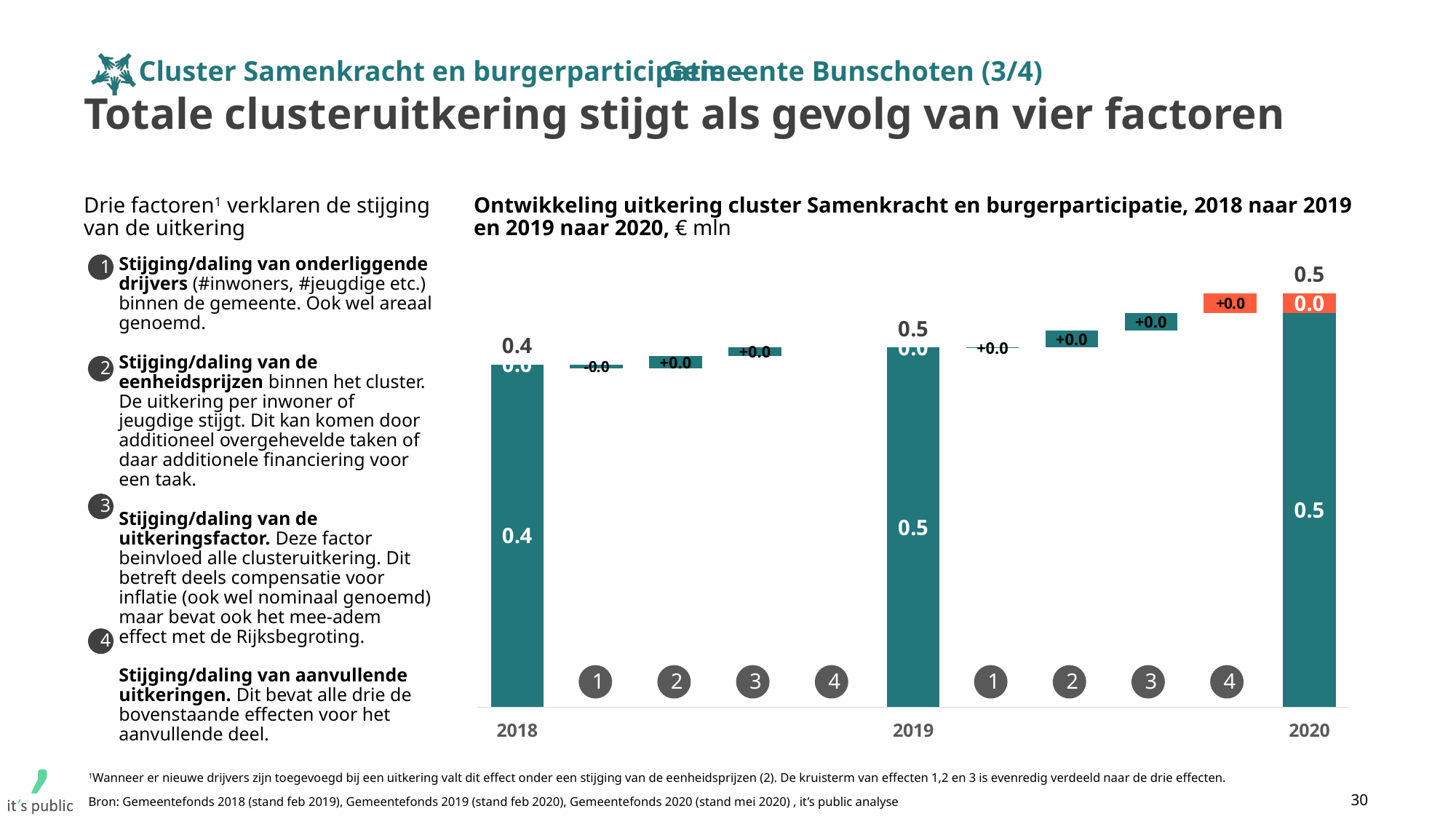
What is the value of the teal (lower) segment of the 2020 bar? 0.5 What is the total uitkering shown for 2018? 0.4 Which is larger, the total for 2018 or the total for 2019? 2019 What is the total uitkering shown for 2019? 0.5 How many year totals (2018, 2019, 2020) are shown on the chart? 3 What kind of chart is shown on the slide? Bar chart (waterfall) What is the total uitkering shown for 2020? 0.5 What is the value labelled on factor 2 between 2019 and 2020? +0.0 Which year has the lowest total uitkering? 2018 Do the year totals rise or fall from 2018 to 2020? Rise What is the value labelled on factor 1 between 2018 and 2019? -0.0 What is the difference between the total for 2019 and the total for 2018? 0.1